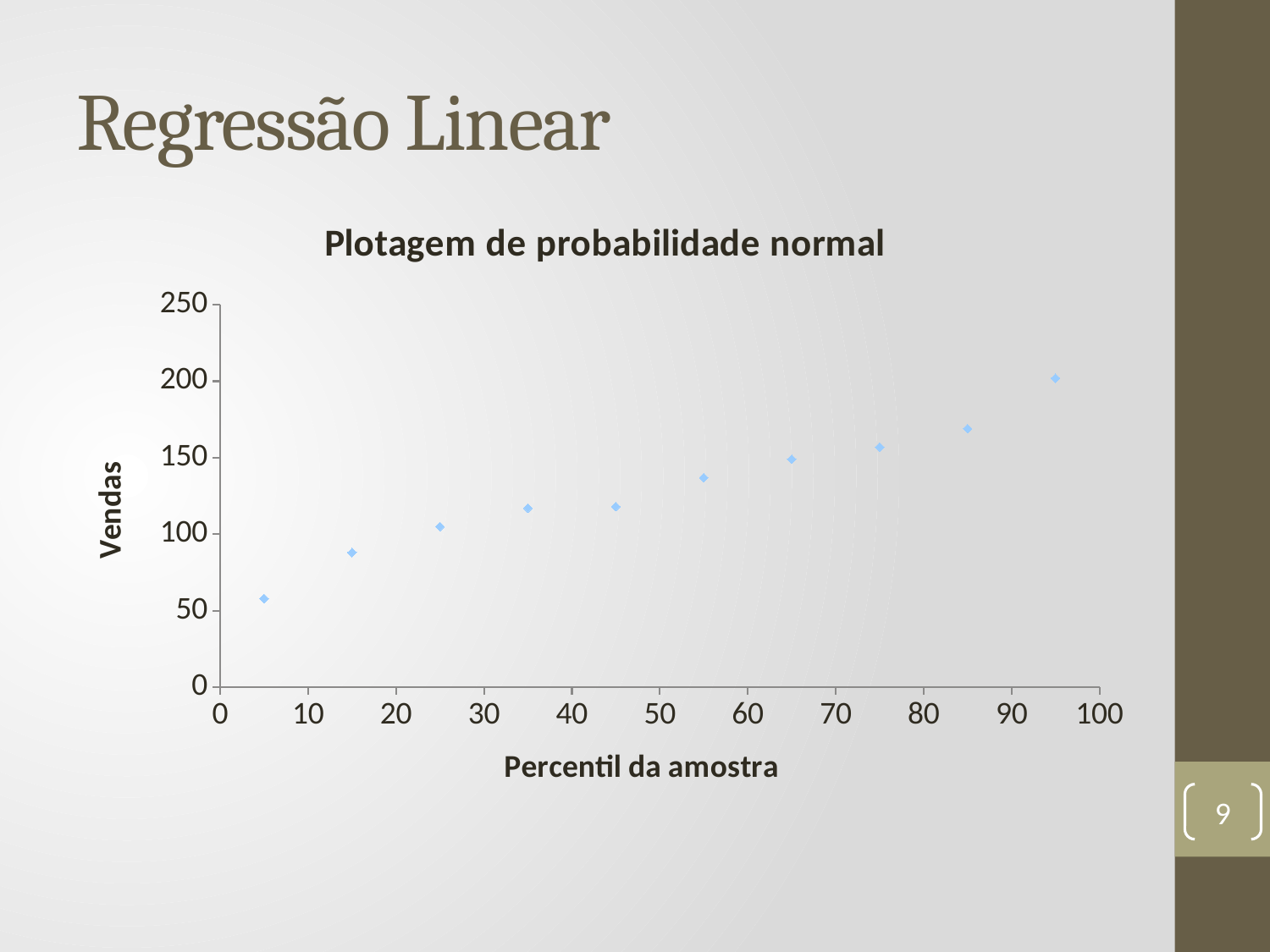
Is the Vendas value at Percentil da amostra 95 greater or less than 150? greater At which Percentil da amostra value is Vendas highest? 95 What kind of chart is shown on the slide? scatter chart Is the Vendas value at Percentil da amostra 55 greater or less than 150? less Is the Vendas value at Percentil da amostra 85 greater or less than 150? greater What is the label of the vertical axis? Vendas How many data points are plotted in the chart? 10 Do the Vendas values rise or fall as Percentil da amostra increases? rise Which has the larger Vendas value: Percentil da amostra 55 or Percentil da amostra 45? 55 What is the title of the chart? Plotagem de probabilidade normal At which Percentil da amostra value is Vendas lowest? 5